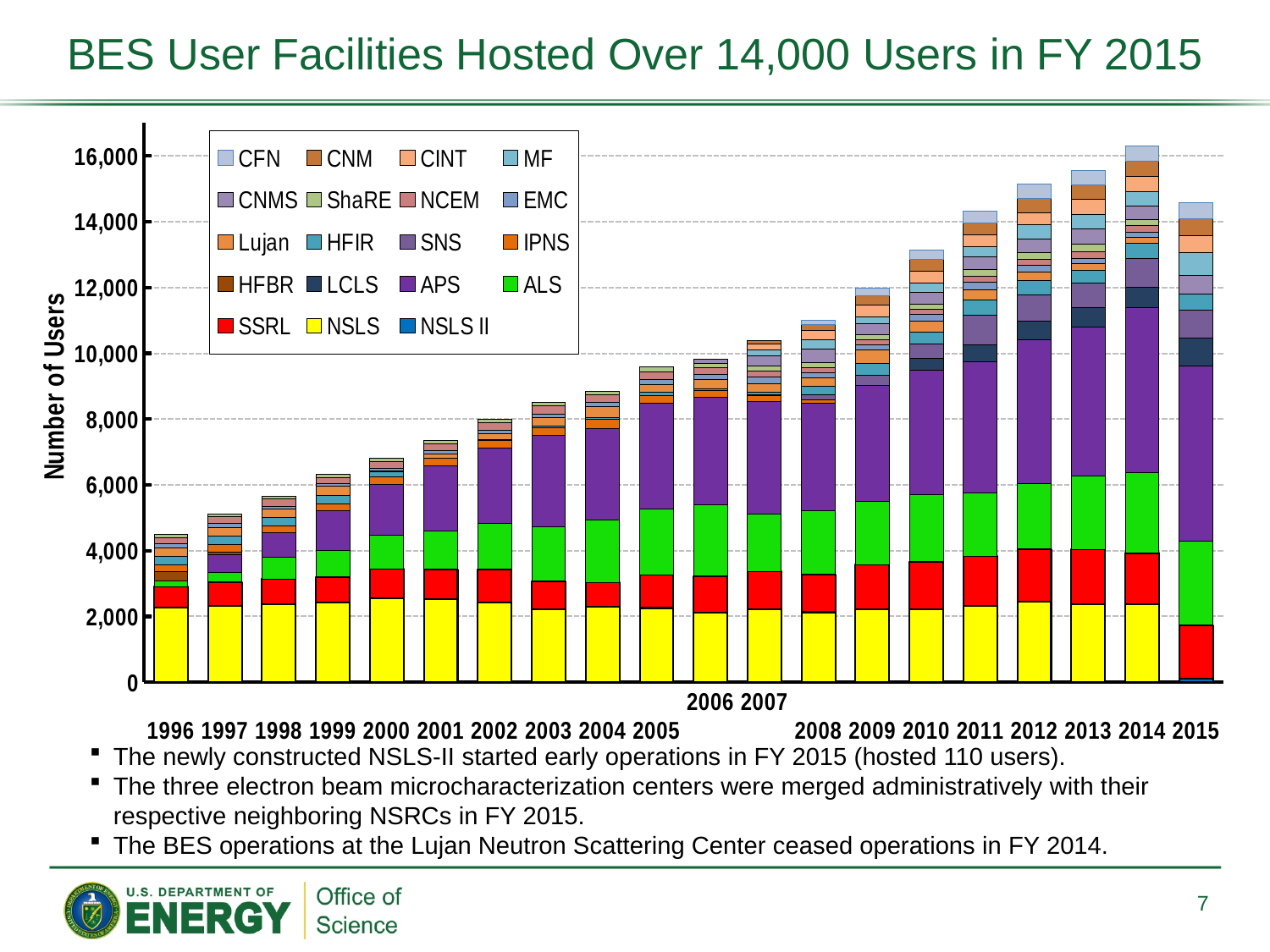
What is the label on the chart's vertical axis? Number of Users Which year had more total users, 2014 or 2015? 2014 Is the total number of users in 2005 greater or less than 10,000? less How many fiscal years are shown along the x axis of the chart? 20 Is the total number of users in 2014 greater or less than 16,000? greater What kind of chart is shown on the slide? Stacked bar chart Which year has the shortest stacked bar (the fewest total users)? 1996 How many facilities does the chart's legend list? 19 Is the total number of users in 2015 greater or less than 14,000? greater Which year has the tallest stacked bar (the most total users)? 2014 Overall, do the total number of users rise or fall from 1996 to 2014? rise